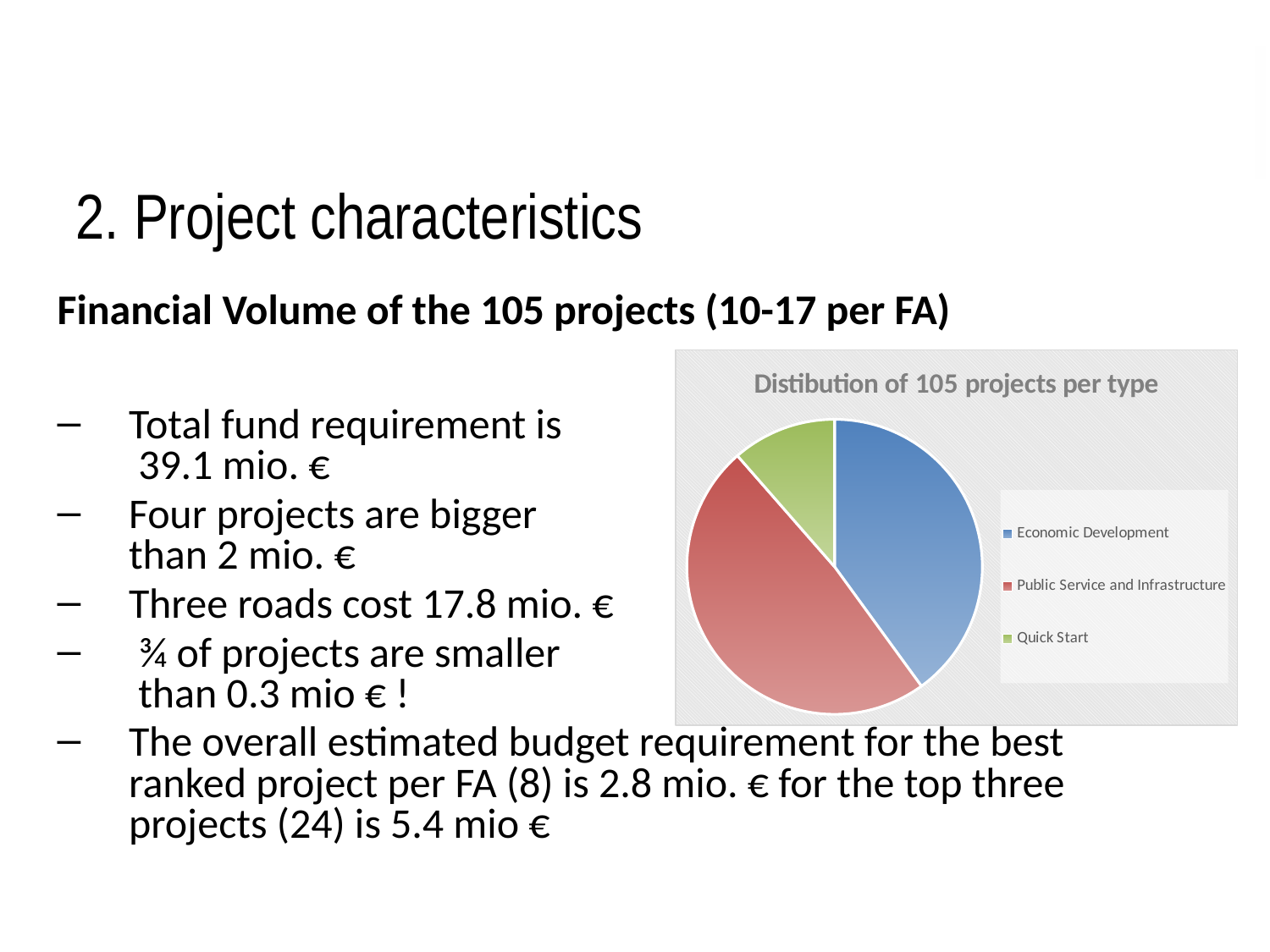
Which slice is larger in the pie chart, Public Service and Infrastructure or Economic Development? Public Service and Infrastructure What is the title of the pie chart? Distibution of 105 projects per type Which project type has the smallest slice in the pie chart? Quick Start Which project type has the largest slice in the pie chart? Public Service and Infrastructure Which slice is larger in the pie chart, Economic Development or Quick Start? Economic Development What kind of chart is shown on the slide? pie chart How many slices does the pie chart have? 3 How many entries does the legend of the pie chart list? 3 Which colour represents Quick Start in the pie chart? green